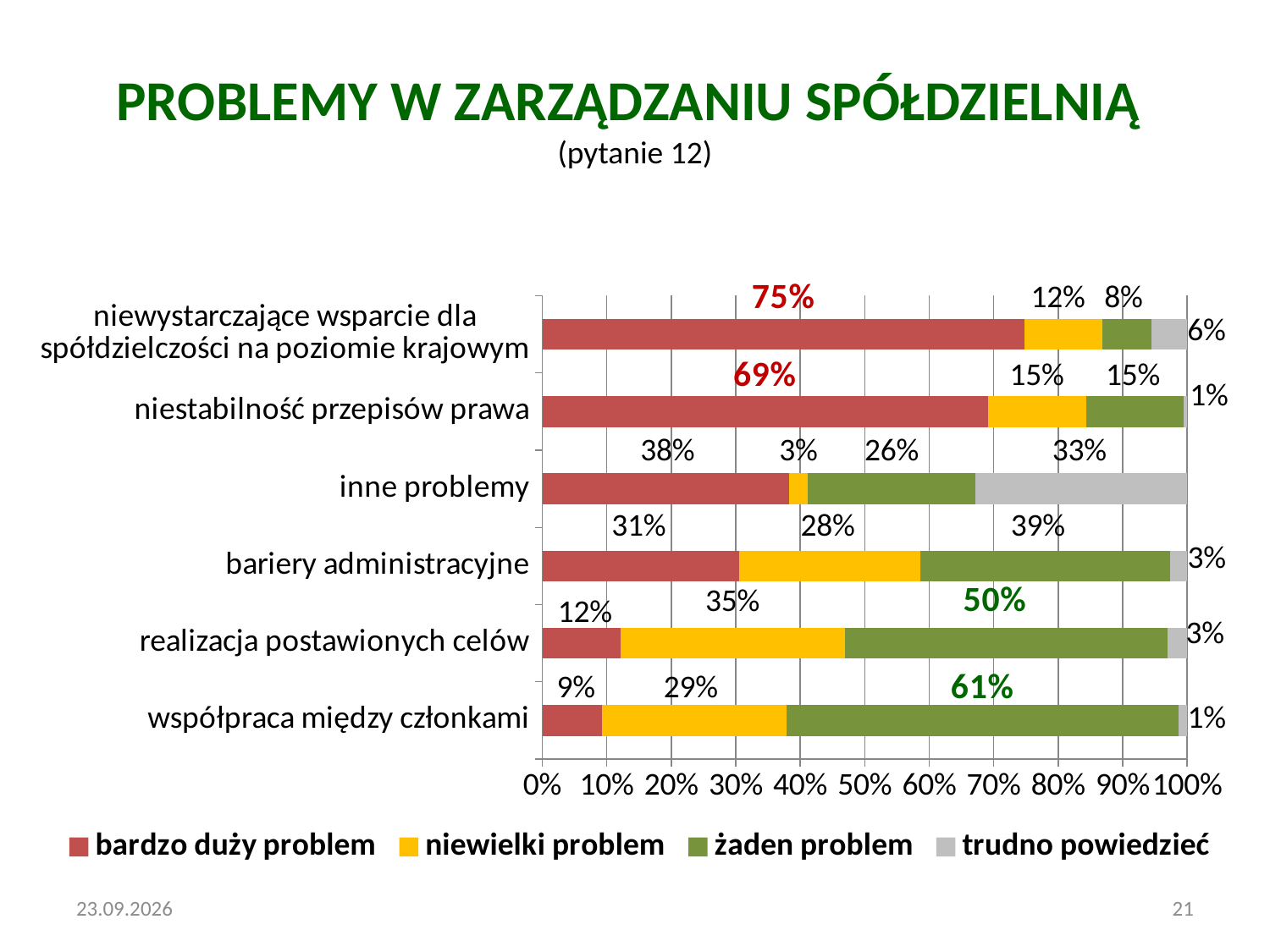
Which is larger: the 'żaden problem' value for 'realizacja postawionych celów' or for 'bariery administracyjne'? realizacja postawionych celów Which category has the highest 'bardzo duży problem' value? niewystarczające wsparcie dla spółdzielczości na poziomie krajowym What percentage of respondents rated 'niewystarczające wsparcie dla spółdzielczości na poziomie krajowym' as 'bardzo duży problem'? 75% What is the 'niewielki problem' value for 'realizacja postawionych celów'? 35% What is the total of the 'bardzo duży problem' and 'niewielki problem' values for 'inne problemy'? 41% What is the 'żaden problem' value for 'współpraca między członkami'? 61% What is the 'trudno powiedzieć' value for 'inne problemy'? 33% What is the difference between the 'bardzo duży problem' values for 'niestabilność przepisów prawa' and 'bariery administracyjne'? 38% How many categories are shown on the chart? 6 What kind of chart is shown on the slide? Stacked bar chart Which category has the lowest 'bardzo duży problem' value? współpraca między członkami How many series does the legend list? 4